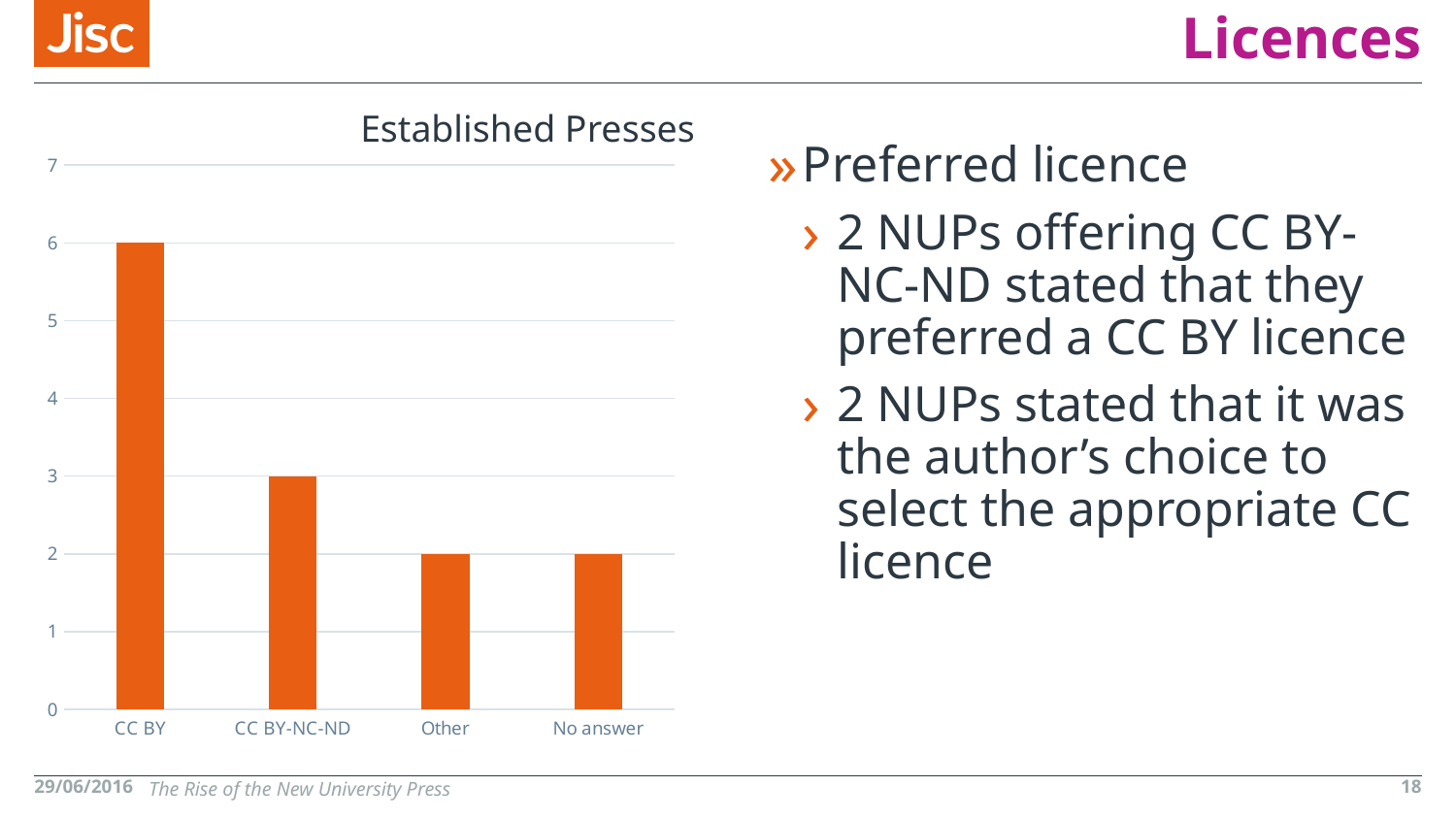
What kind of chart is the Established Presses chart? bar chart What is the value for No answer in the Established Presses chart? 2 What is the difference between the values for CC BY and Other in the Established Presses chart? 4 Which category has the highest value in the Established Presses chart? CC BY What is the value for CC BY-NC-ND in the Established Presses chart? 3 What is the value for Other in the Established Presses chart? 2 What is the difference between the values for CC BY and CC BY-NC-ND in the Established Presses chart? 3 Is the value for CC BY in the Established Presses chart greater or less than 5? greater What is the title of the chart on the slide? Established Presses How many categories are shown on the x axis of the Established Presses chart? 4 What is the value for CC BY in the Established Presses chart? 6 Which is larger in the Established Presses chart, the value for CC BY-NC-ND or the value for Other? CC BY-NC-ND